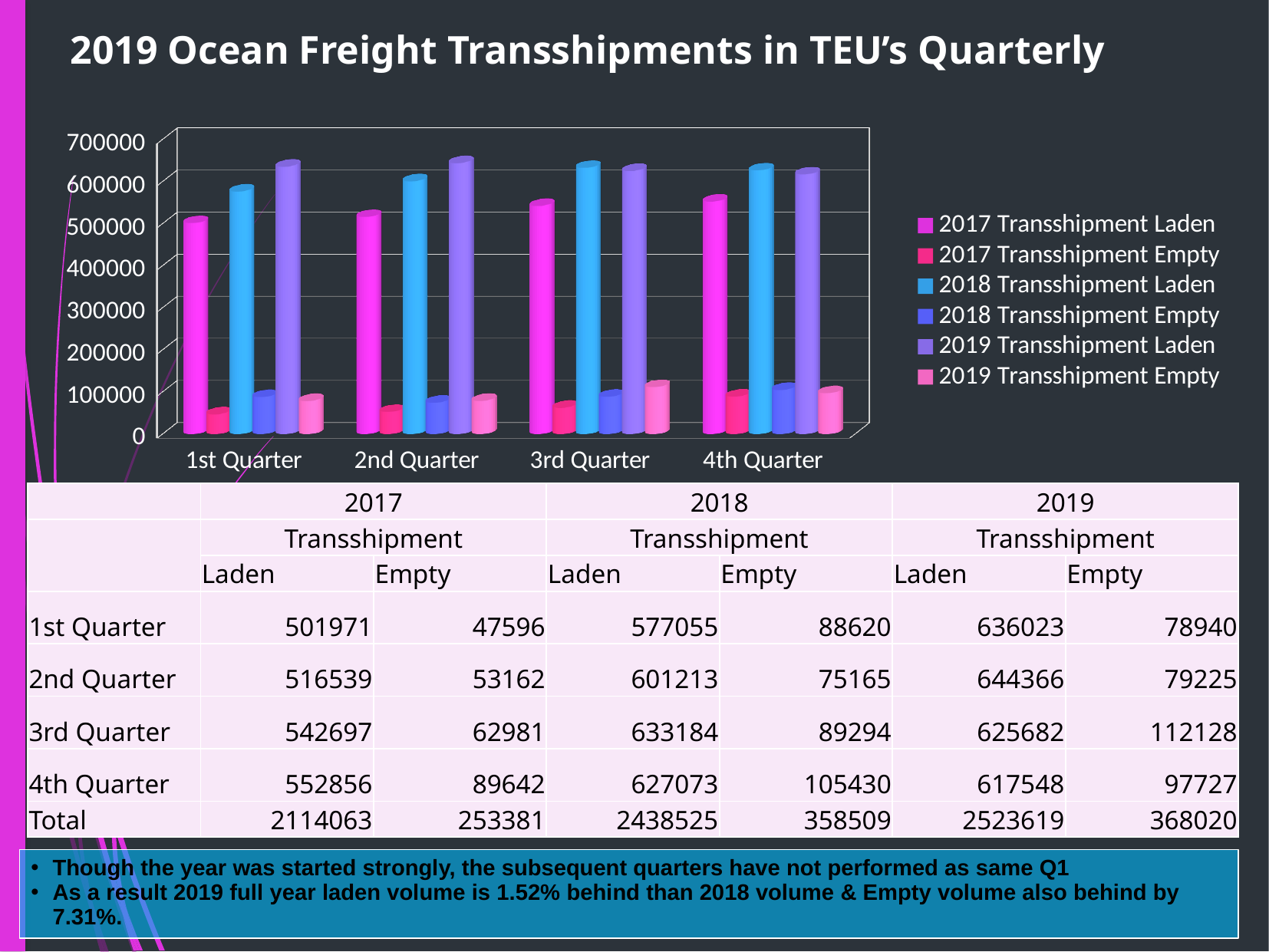
What is the 2018 Transshipment Empty value for the 4th Quarter? 105430 Which quarter has the lowest 2017 Transshipment Empty value? 1st Quarter In the 3rd Quarter, which is larger: 2019 Transshipment Empty or 2018 Transshipment Empty? 2019 Transshipment Empty Which quarter has the highest 2019 Transshipment Laden value? 2nd Quarter How many quarters are shown on the x axis of the chart? 4 What is the title of the slide containing the chart? 2019 Ocean Freight Transshipments in TEU's Quarterly What is the difference between the 2018 Transshipment Laden and 2017 Transshipment Laden values in the 2nd Quarter? 84674 Do the 2017 Transshipment Laden values rise or fall from the 1st Quarter to the 4th Quarter? Rise What kind of chart is shown on the slide? Bar chart Is the 2018 Transshipment Laden value for the 3rd Quarter greater or less than 600000? greater How many series does the chart legend list? 6 What is the 2019 Transshipment Laden value for the 1st Quarter? 636023